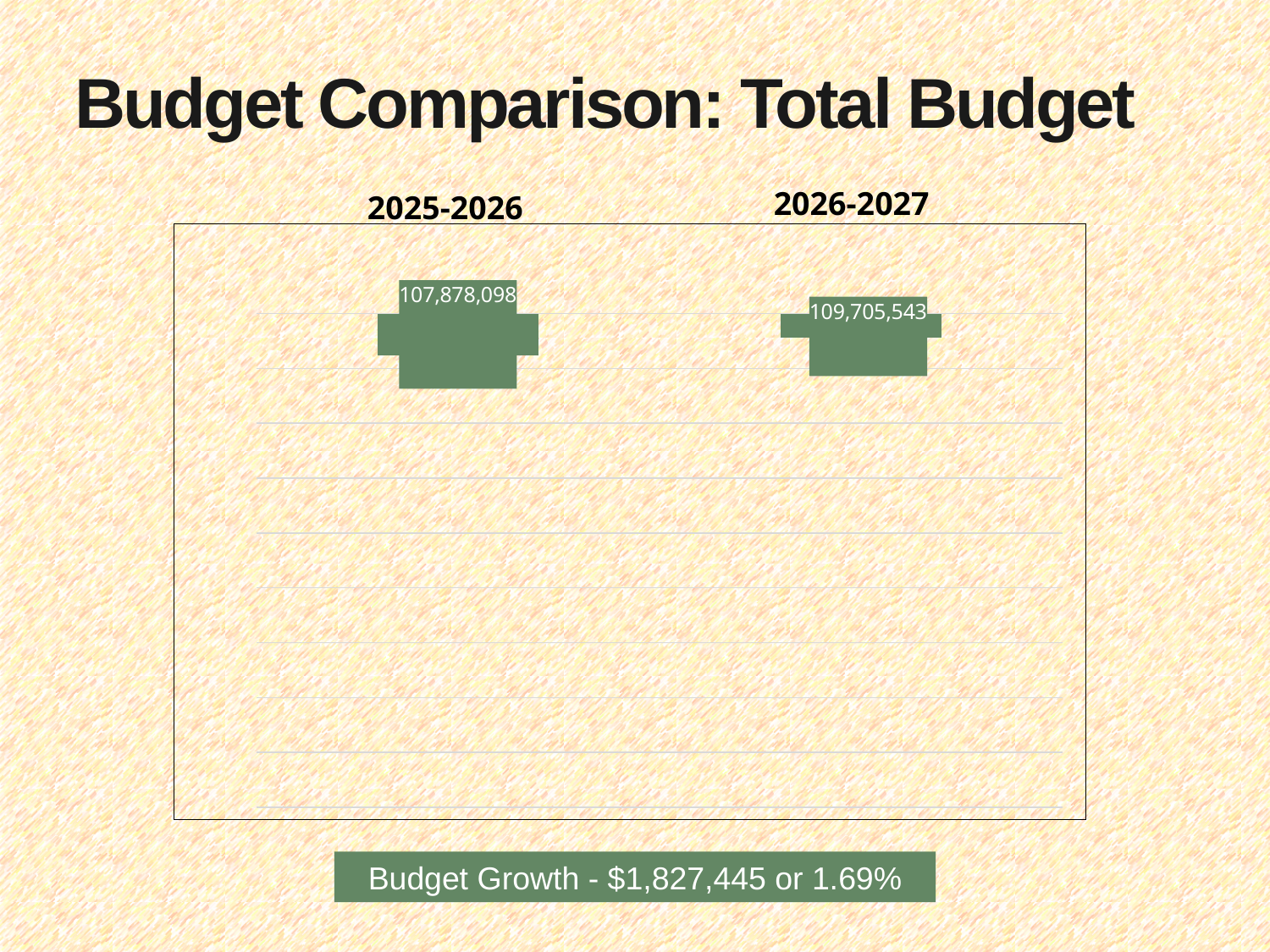
Does the total budget rise or fall from 2025-2026 to 2026-2027? rise Which budget year shows the highest total budget? 2026-2027 What is the total budget value shown for 2026-2027? 109,705,543 Which budget year shows the lowest total budget? 2025-2026 Which year has the higher total budget, 2025-2026 or 2026-2027? 2026-2027 What is the total budget value shown for 2025-2026? 107,878,098 What is the difference between the 2026-2027 and 2025-2026 total budgets? 1,827,445 What budget growth percentage is stated below the chart? 1.69% How many budget years are plotted on the chart? 2 What is the title of the slide containing the chart? Budget Comparison: Total Budget